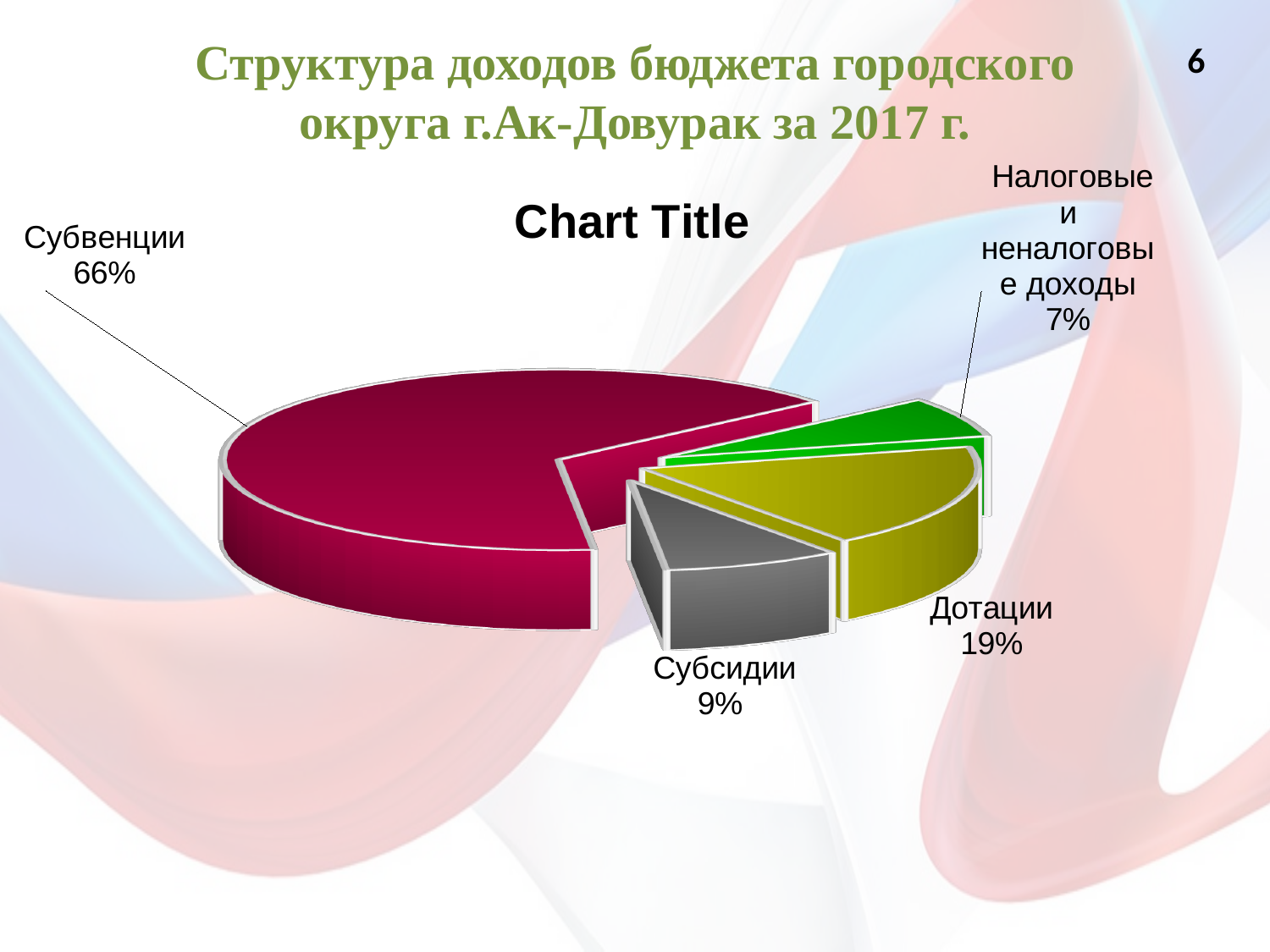
How many slices does the pie chart have? 4 What share of the pie does Налоговые и неналоговые доходы hold? 7% Which category has the largest slice of the pie? Субвенции What is the difference in percentage points between Субсидии and Налоговые и неналоговые доходы? 2 What share of the pie does Дотации hold? 19% What share of the pie does Субвенции hold? 66% What is the difference in percentage points between Субвенции and Дотации? 47 Which is larger, the share for Субсидии or the share for Дотации? Дотации What kind of chart is shown on the slide? Pie chart Which category has the smallest slice of the pie? Налоговые и неналоговые доходы What title is printed above the pie chart? Chart Title